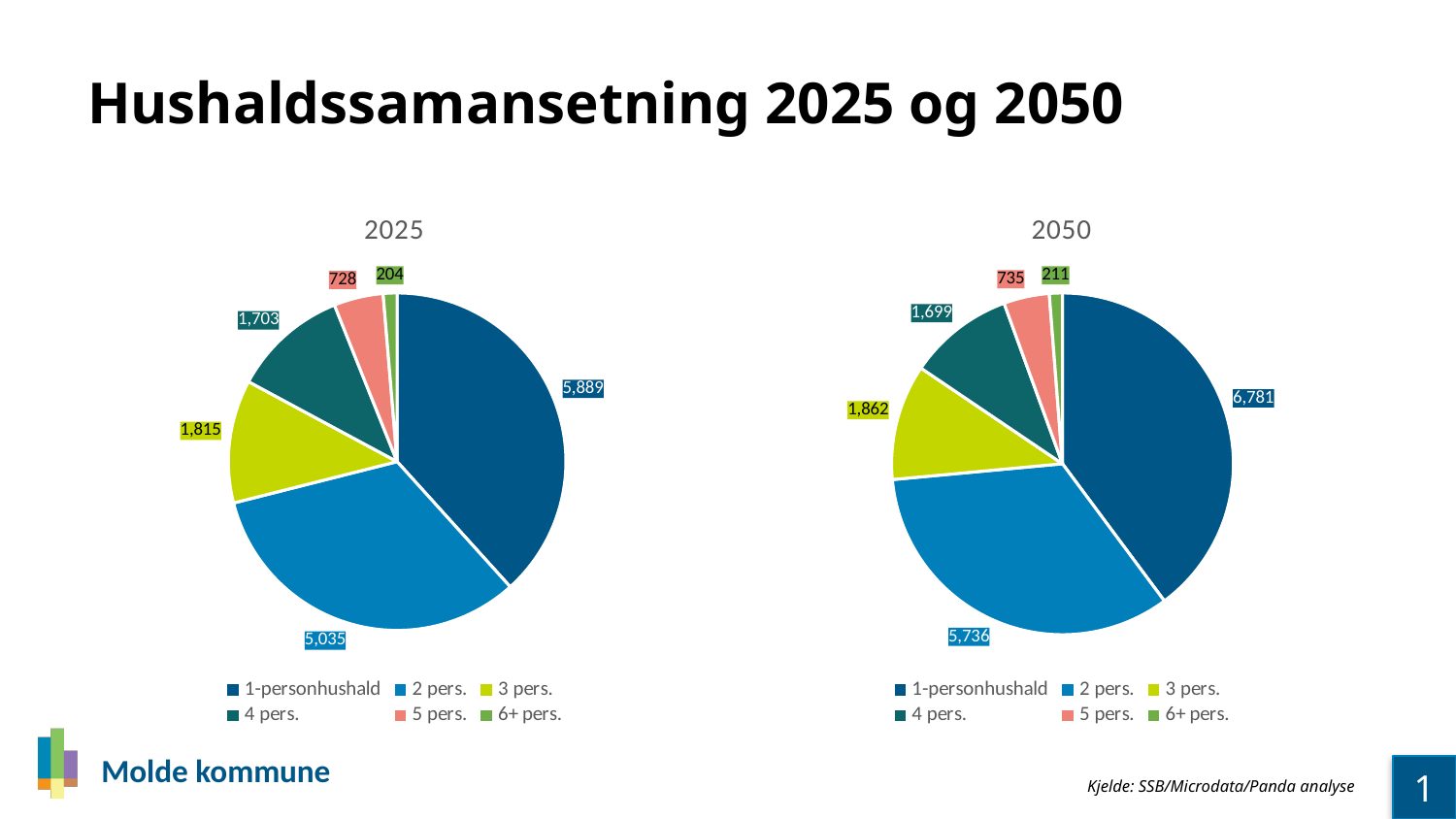
In the 2050 pie chart, which is larger: 3 pers. or 4 pers.? 3 pers. What is the title of the left chart? 2025 In the 2025 pie chart, what is the difference between the values for 1-personhushald and 2 pers.? 854 In the 2025 pie chart, what is the value for 5 pers.? 728 In the 2025 pie chart, which category has the smallest slice? 6+ pers. What is the difference between the 1-personhushald value in the 2050 chart and the 1-personhushald value in the 2025 chart? 892 What type of chart is used for the 2050 data? Pie chart In the 2050 pie chart, which category has the largest slice? 1-personhushald How many slices does the 2025 pie chart have? 6 In the 2025 pie chart, what is the value for 1-personhushald? 5,889 In the 2050 pie chart, what is the value for 6+ pers.? 211 In the 2050 pie chart, what is the value for 2 pers.? 5,736